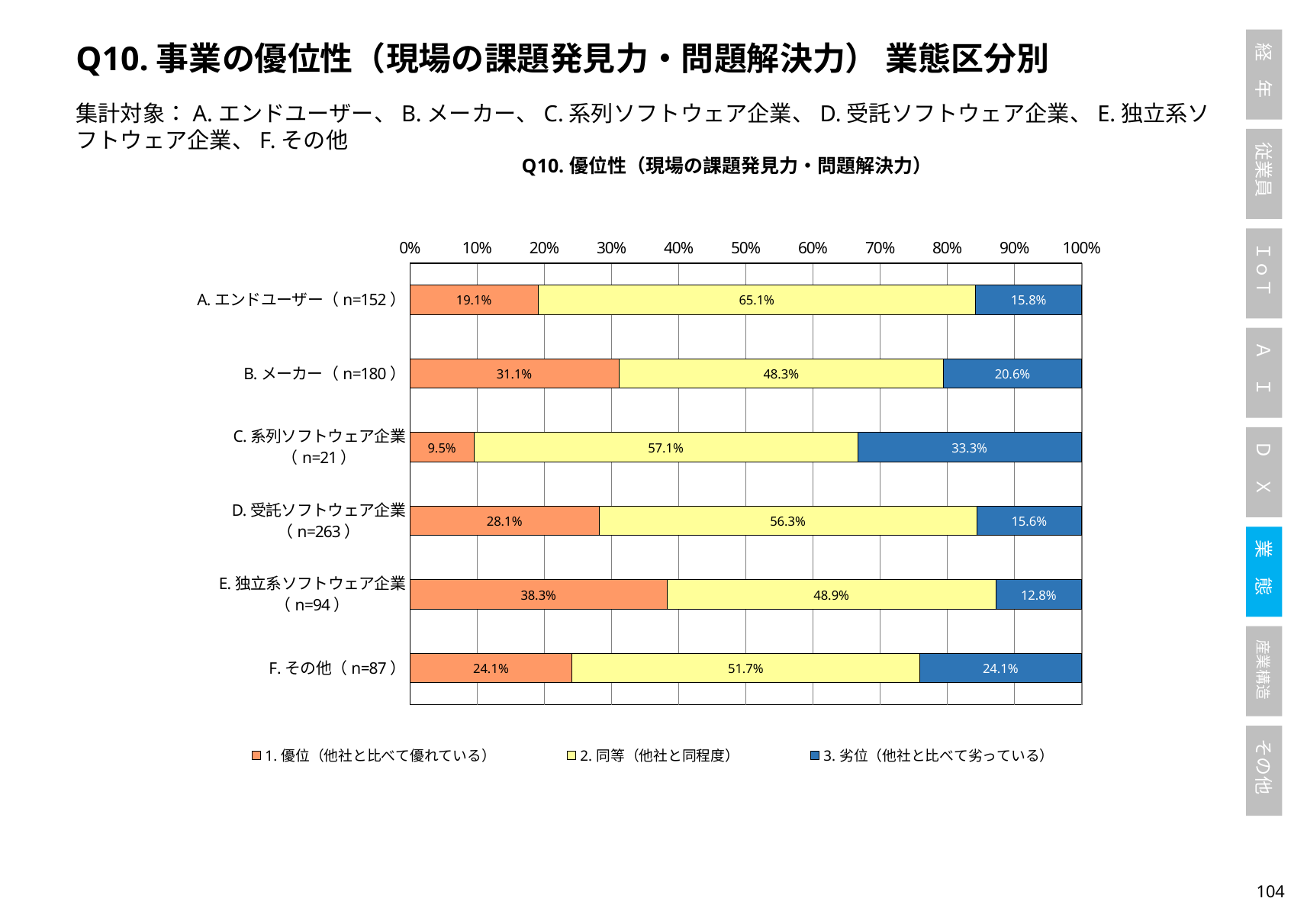
What is the value of 1. 優位（他社と比べて優れている） for A. エンドユーザー（n=152）? 19.1% What is the value of 3. 劣位（他社と比べて劣っている） for E. 独立系ソフトウェア企業（n=94）? 12.8% Which category has the lowest value for 3. 劣位（他社と比べて劣っている）? E. 独立系ソフトウェア企業（n=94） What is the value of 2. 同等（他社と同程度） for C. 系列ソフトウェア企業（n=21）? 57.1% Which category has the highest value for 3. 劣位（他社と比べて劣っている）? C. 系列ソフトウェア企業（n=21） What kind of chart is shown on the slide? Stacked bar chart How many categories are shown on the chart? 6 Which category has the highest value for 1. 優位（他社と比べて優れている）? E. 独立系ソフトウェア企業（n=94） How many series does the legend list? 3 What is the title of the chart? Q10. 優位性（現場の課題発見力・問題解決力） Which is larger: the 2. 同等 value for A. エンドユーザー（n=152） or for B. メーカー（n=180）? A. エンドユーザー（n=152） What is the difference between the 1. 優位 values for B. メーカー（n=180） and A. エンドユーザー（n=152）? 12.0%